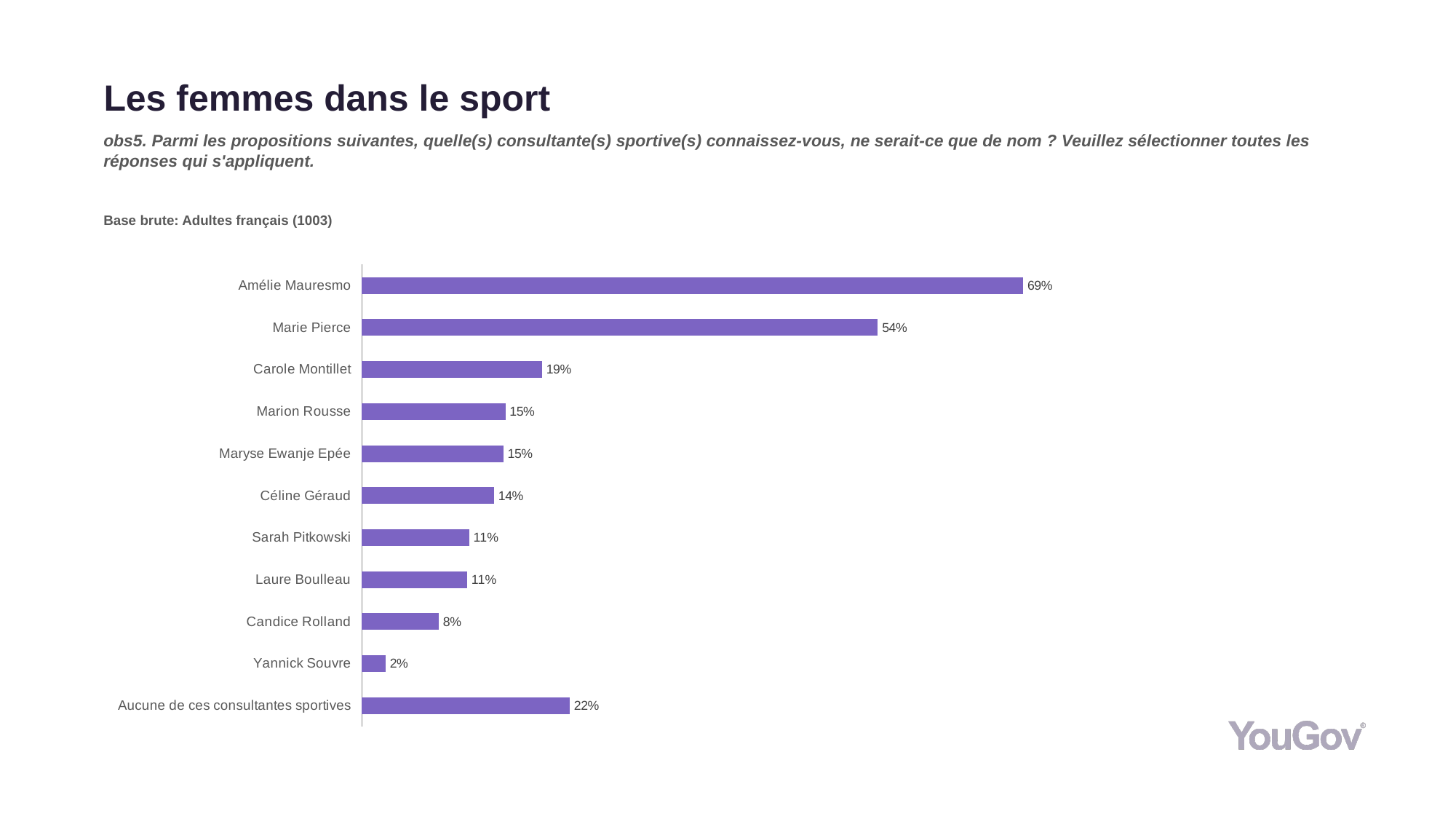
What is the difference between the values for Carole Montillet and Céline Géraud? 5% What is the value for Aucune de ces consultantes sportives? 22% Which is larger, the value for Marie Pierce or the value for Carole Montillet? Marie Pierce What is the value for Candice Rolland? 8% Which category has the highest value? Amélie Mauresmo What is the difference between the values for Amélie Mauresmo and Marie Pierce? 15% What kind of chart is shown on the slide? Bar chart How many categories are shown in the chart? 11 What is the value for Amélie Mauresmo? 69% What is the title of the slide? Les femmes dans le sport What is the value for Carole Montillet? 19% Which category has the lowest value? Yannick Souvre